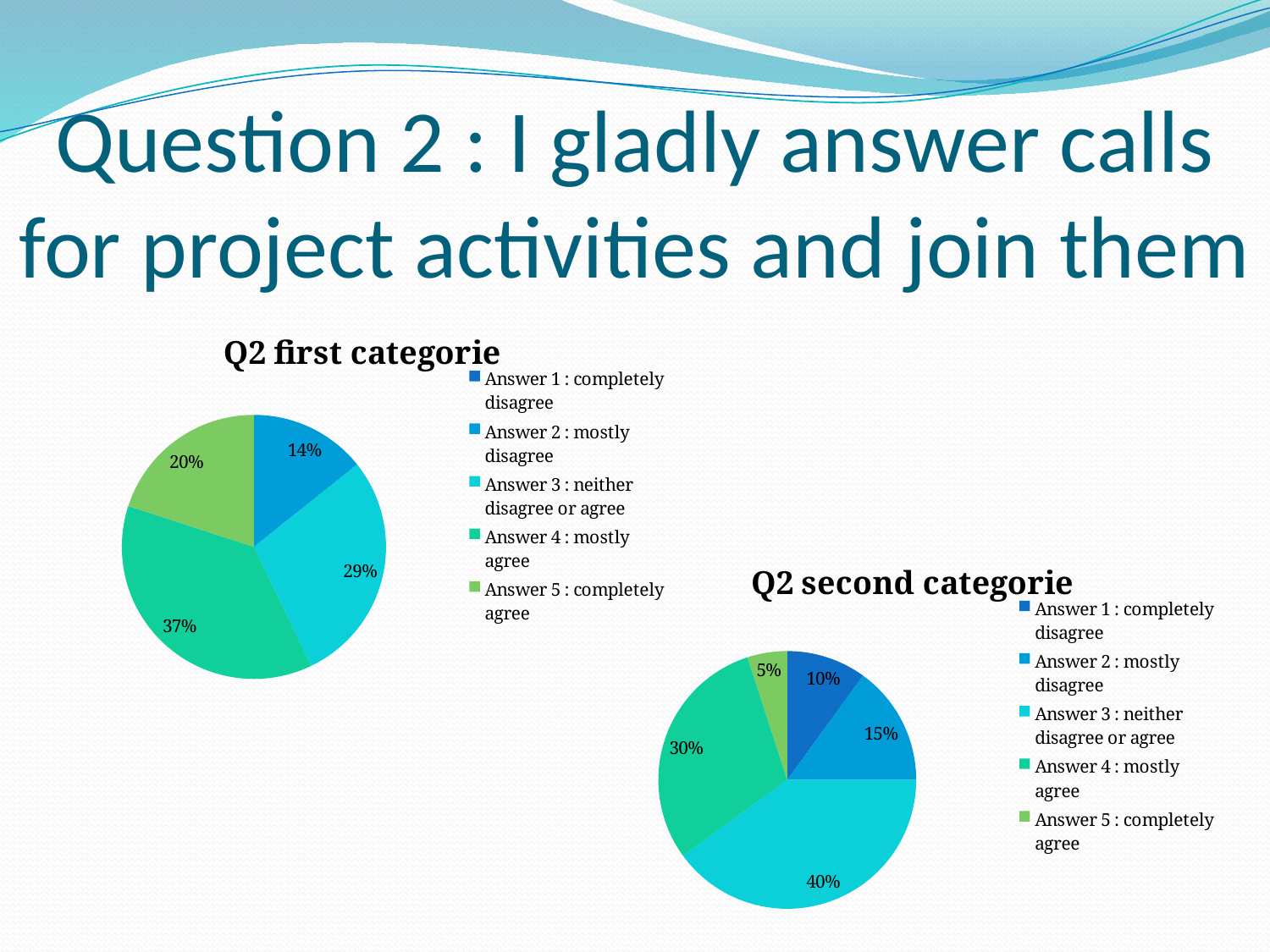
In the 'Q2 second categorie' chart, which answer has the smallest slice? Answer 5 : completely agree In the 'Q2 first categorie' chart, what share does 'Answer 3 : neither disagree or agree' have? 29% What kind of chart is the 'Q2 first categorie' chart? pie chart In the 'Q2 second categorie' chart, which is larger: the share for 'Answer 2 : mostly disagree' or for 'Answer 1 : completely disagree'? Answer 2 : mostly disagree In the 'Q2 second categorie' chart, what share does 'Answer 3 : neither disagree or agree' have? 40% In the 'Q2 second categorie' chart, which answer has the largest slice? Answer 3 : neither disagree or agree In the 'Q2 first categorie' chart, which answer has the largest slice? Answer 4 : mostly agree In the 'Q2 first categorie' chart, what share does 'Answer 4 : mostly agree' have? 37% In the 'Q2 second categorie' chart, what is the difference between the shares of 'Answer 3 : neither disagree or agree' and 'Answer 4 : mostly agree'? 10% How many entries does the legend of the 'Q2 second categorie' chart list? 5